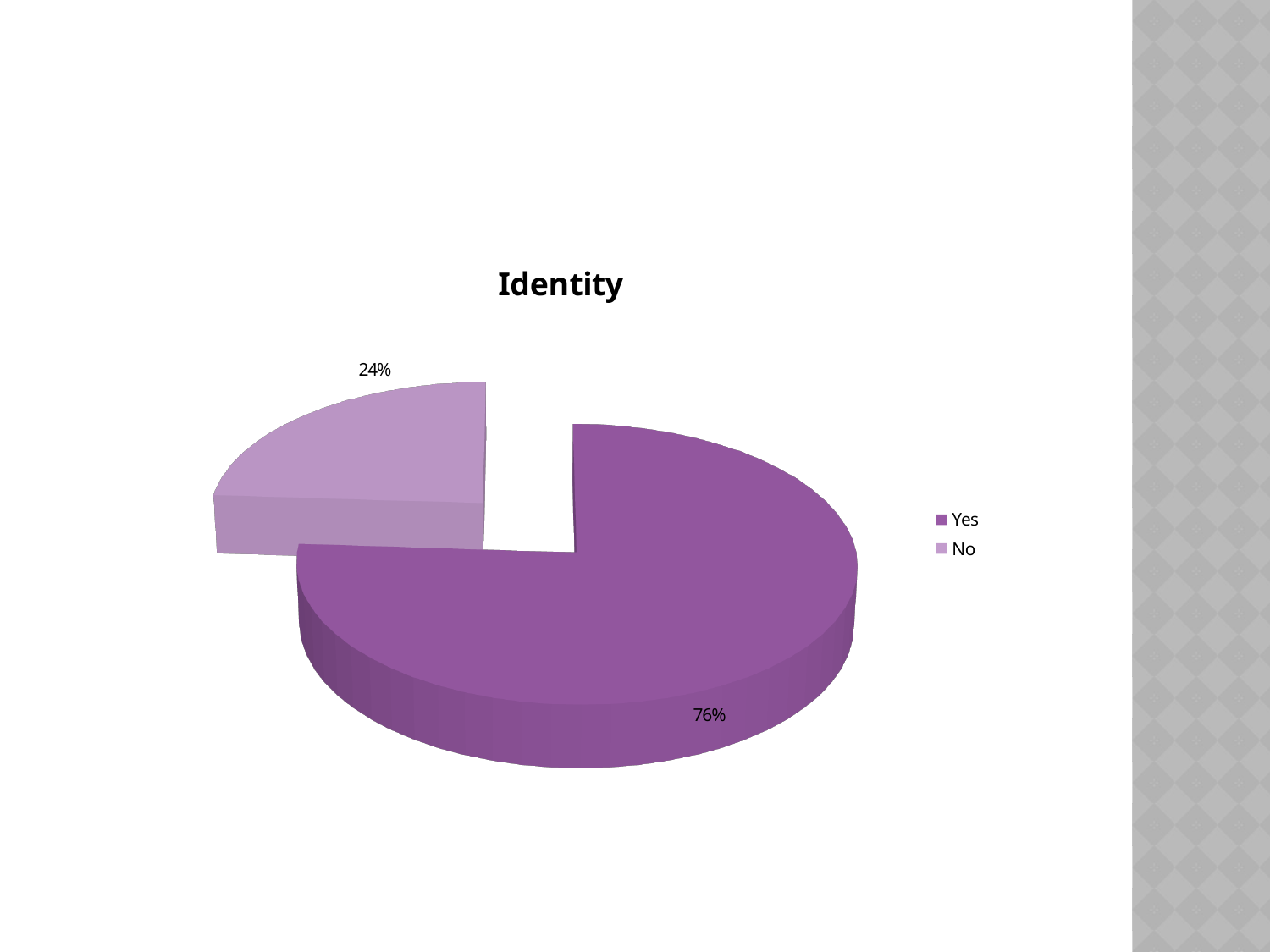
What is the difference in percentage points between the Yes and No slices? 52 How many slices does the pie chart have? 2 Which is larger, the Yes slice or the No slice? Yes What is the title of the chart? Identity Which slice is the smallest? No Which legend entry is shown in the lighter purple colour? No What kind of chart is shown on the slide? pie chart How many entries does the legend list? 2 Which slice is the largest? Yes Is the share for Yes greater or less than 50%? greater What share of the pie does the No slice represent? 24% What share of the pie does the Yes slice represent? 76%